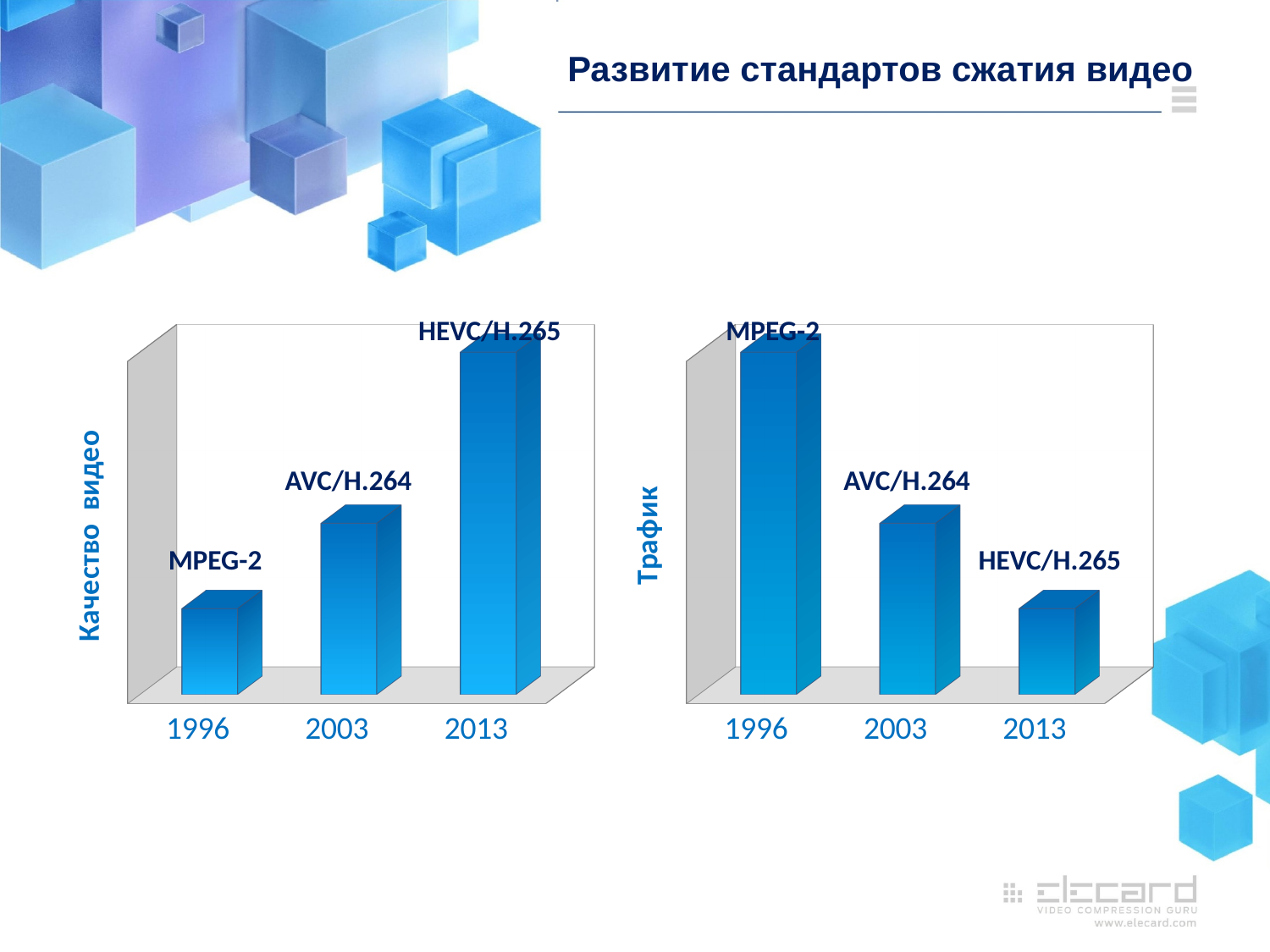
In the right chart (Трафик), do the bars rise or fall from 1996 to 2013? fall In the right chart (Трафик), which year has the tallest bar? 1996 What kind of chart is the left chart (Качество видео)? bar chart In the left chart (Качество видео), which standard is labelled on the 2003 bar? AVC/H.264 What is the y-axis label of the right chart? Трафик In the left chart (Качество видео), which year has the shortest bar? 1996 How many bars are plotted in the right chart (Трафик)? 3 In the left chart (Качество видео), which year has the tallest bar? 2013 In the left chart (Качество видео), which bar is taller: MPEG-2 or AVC/H.264? AVC/H.264 In the right chart (Трафик), which year has the shortest bar? 2013 In the right chart (Трафик), which bar is taller: AVC/H.264 or HEVC/H.265? AVC/H.264 In the left chart (Качество видео), do the bars rise or fall from 1996 to 2013? rise